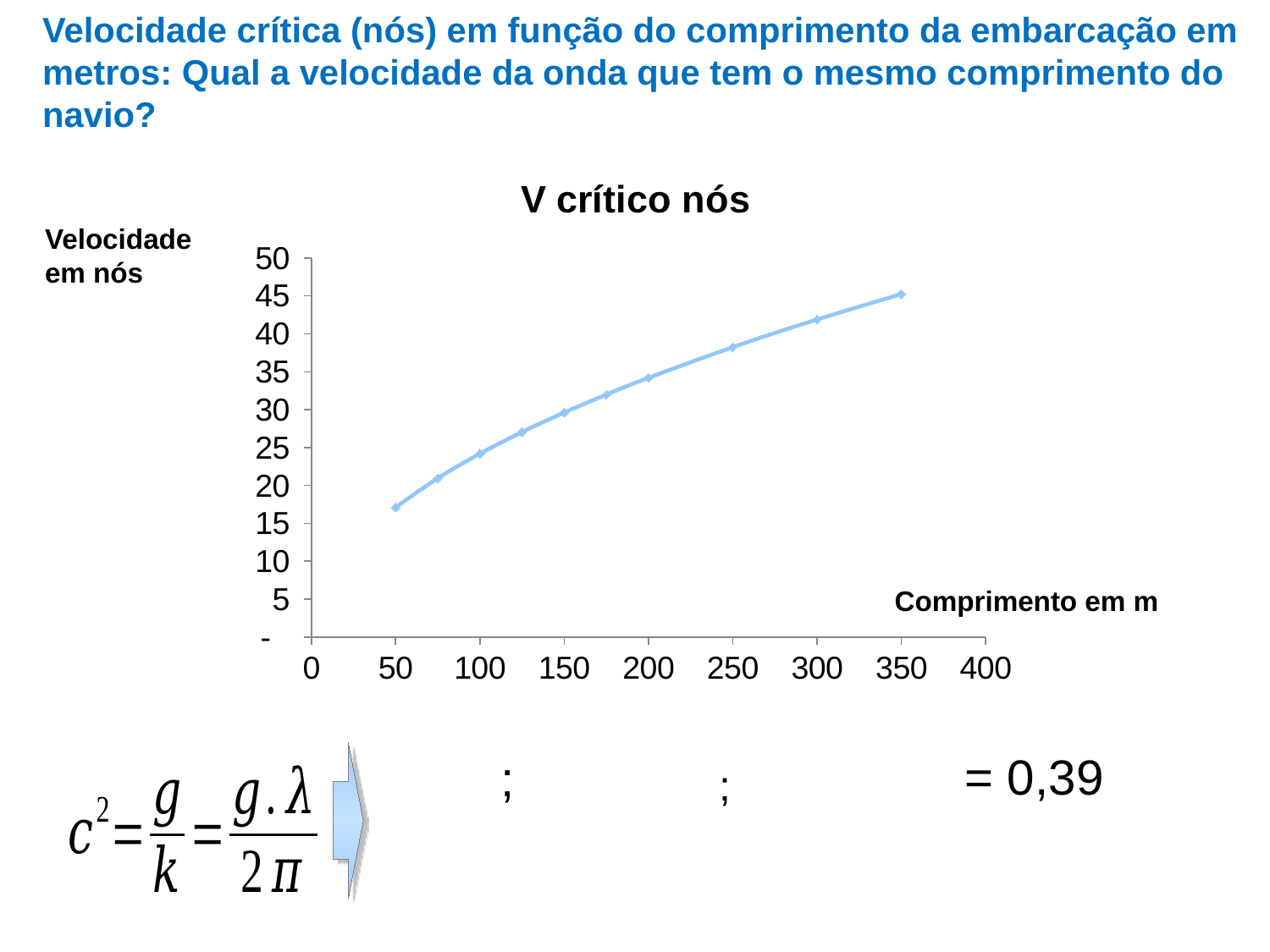
What is the label of the x axis of the chart? Comprimento em m Do the values rise or fall as the length (Comprimento em m) increases along the x axis? rise What kind of chart is shown on the slide? line chart At which length in metres is the critical speed lowest? 50 Is the value for a length of 350 m greater or less than 40? greater Which is larger, the value at 150 m or the value at 300 m? 300 m What is the title of the chart? V crítico nós Is the value for a length of 50 m greater or less than 20? less Is the value for a length of 100 m greater or less than 30? less At which length in metres is the critical speed highest? 350 How many data points are plotted on the chart? 10